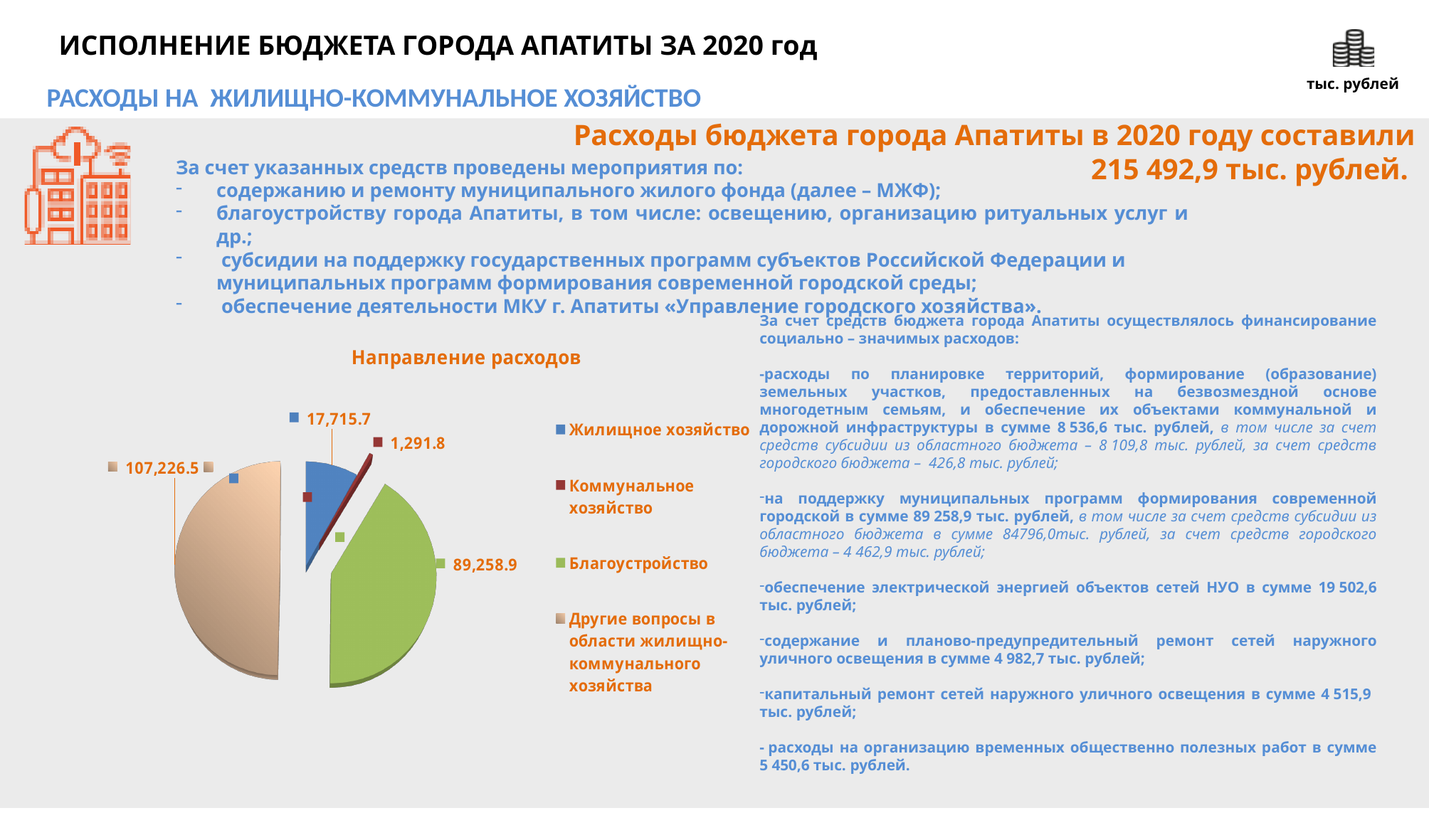
In the pie chart "Направление расходов", which category has the largest value? Другие вопросы в области жилищно-коммунального хозяйства In the pie chart "Направление расходов", what is the value for Благоустройство? 89,258.9 In the pie chart "Направление расходов", what is the value for Другие вопросы в области жилищно-коммунального хозяйства? 107,226.5 In the pie chart "Направление расходов", what is the difference between Другие вопросы в области жилищно-коммунального хозяйства and Благоустройство? 17,967.6 In the pie chart "Направление расходов", what colour is the slice for Благоустройство? green In the pie chart "Направление расходов", what is the value for Коммунальное хозяйство? 1,291.8 In the pie chart "Направление расходов", how many categories are shown? 4 In the pie chart "Направление расходов", what is the value for Жилищное хозяйство? 17,715.7 In the pie chart "Направление расходов", which is larger: Благоустройство or Жилищное хозяйство? Благоустройство What kind of chart is shown under the title "Направление расходов"? pie chart In the pie chart "Направление расходов", which category has the smallest value? Коммунальное хозяйство In the pie chart "Направление расходов", what is the difference between Жилищное хозяйство and Коммунальное хозяйство? 16,423.9